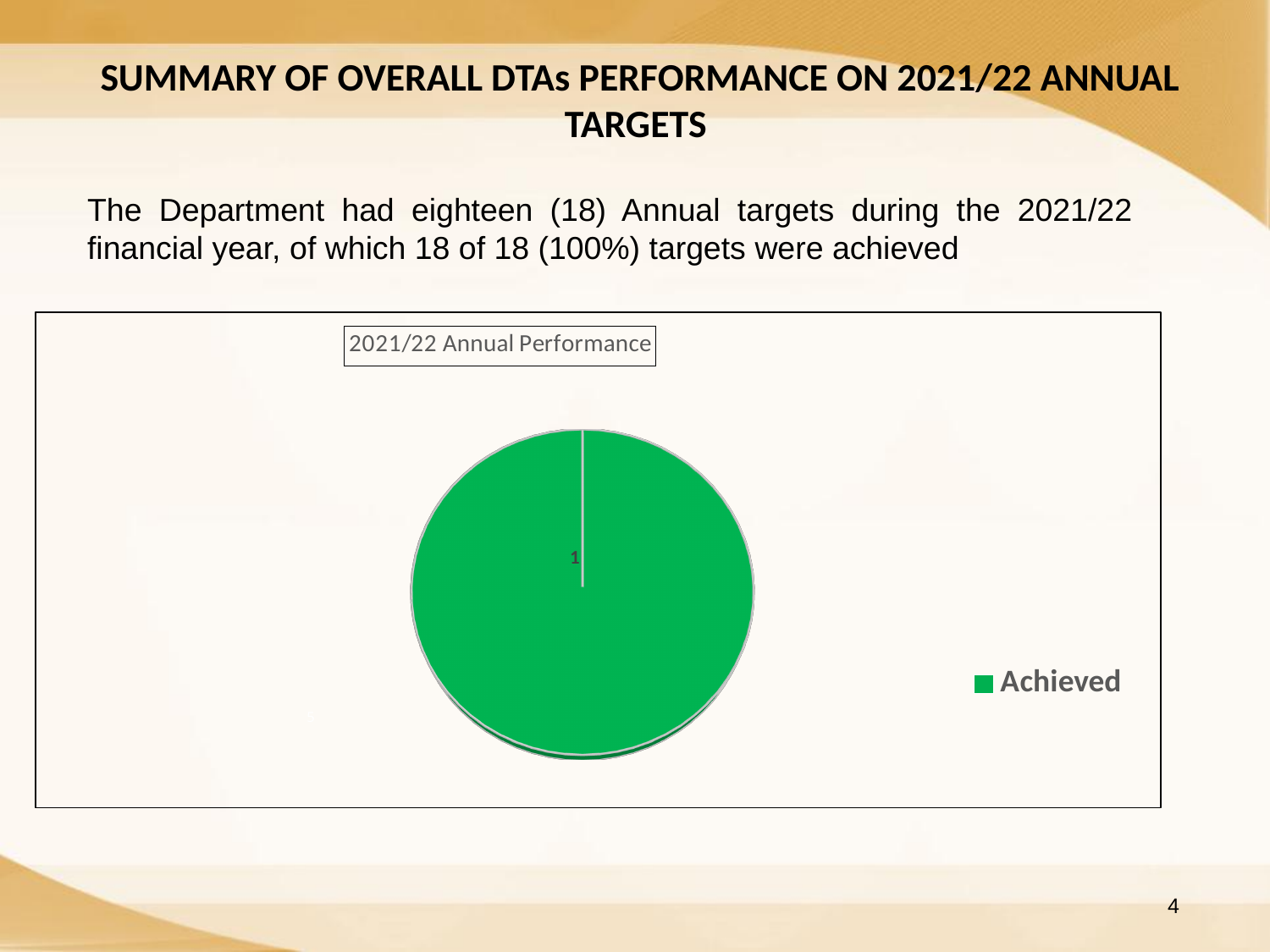
What is the data label shown on the Achieved slice? 1 How many entries does the chart legend list? 1 What category does the legend of the chart list? Achieved What share of the pie does the Achieved slice take up? 100% What is the title of the chart? 2021/22 Annual Performance How many slices does the pie chart have? 1 What kind of chart is shown on the slide? pie chart